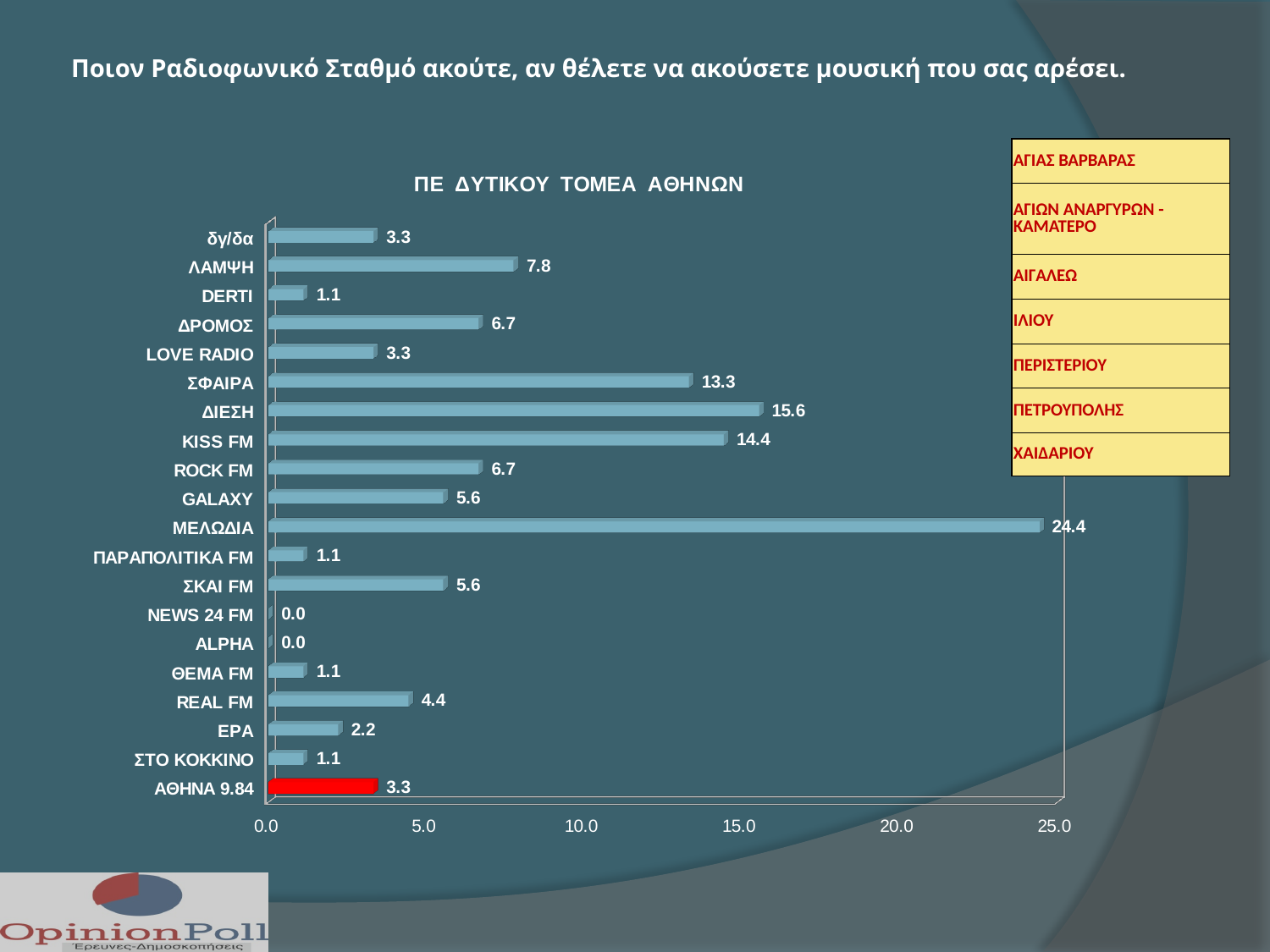
Which has a larger value, ΣΦΑΙΡΑ or KISS FM? KISS FM What is the value for REAL FM? 4.4 What is the value for ΜΕΛΩΔΙΑ? 24.4 What is the value for ΛΑΜΨΗ? 7.8 Which radio station has the highest value? ΜΕΛΩΔΙΑ Is the value for ΔΙΕΣΗ greater or less than 15.0? greater What is the title of the chart? ΠΕ ΔΥΤΙΚΟΥ ΤΟΜΕΑ ΑΘΗΝΩΝ What kind of chart is shown on the slide? bar chart How many radio stations are listed on the chart? 19 What is the value for KISS FM? 14.4 What is the difference between the values for ΜΕΛΩΔΙΑ and ΔΙΕΣΗ? 8.8 Which radio station's bar is coloured red? ΑΘΗΝΑ 9.84